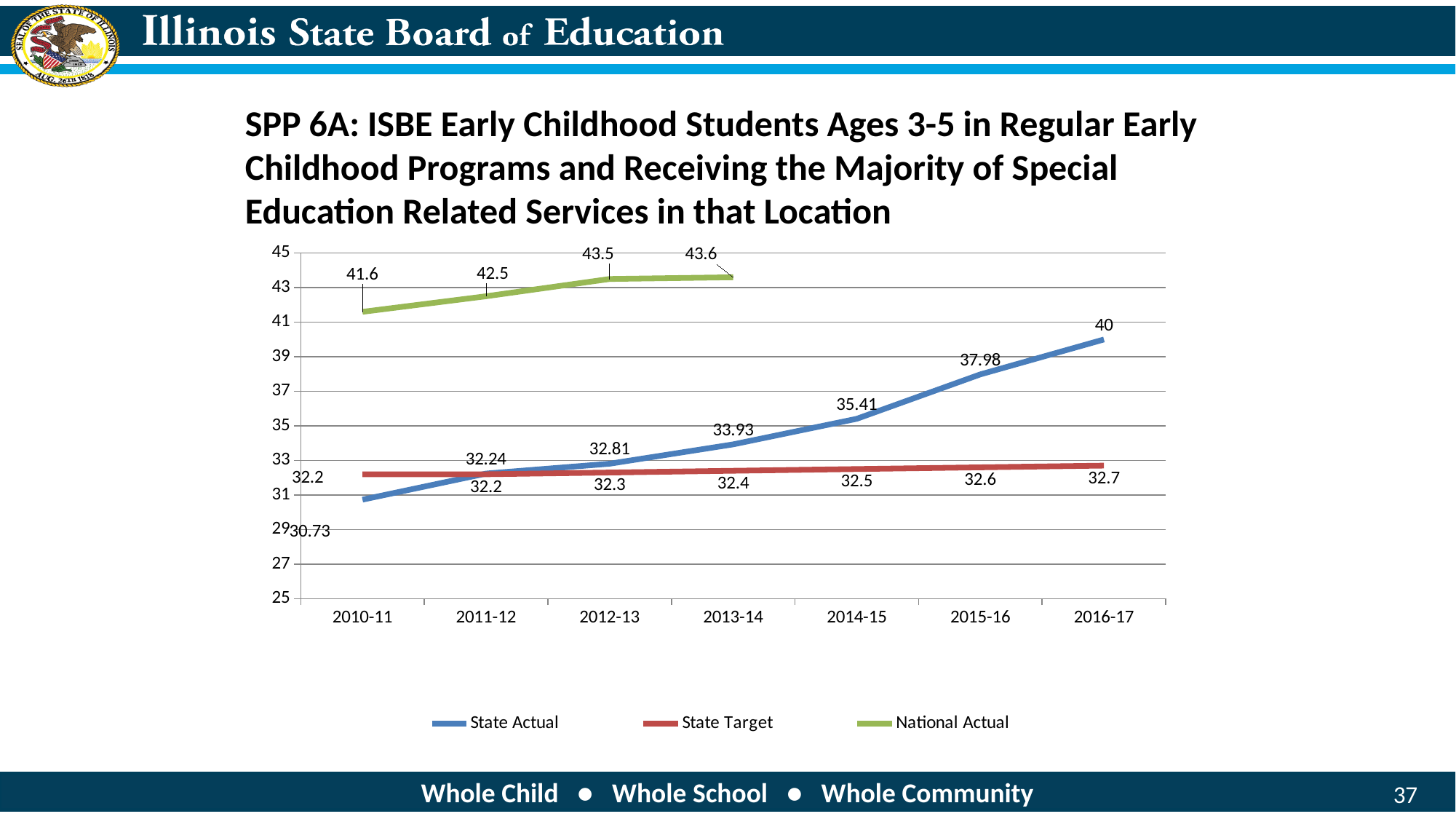
What type of chart is shown on the slide? line chart In which school year is the State Actual value lowest? 2010-11 How many series does the legend list? 3 What is the State Target value for 2013-14? 32.4 In which school year is the National Actual value highest? 2013-14 How many school years are shown on the x axis? 7 What is the National Actual value for 2012-13? 43.5 What is the State Actual value for 2016-17? 40 Does the State Actual series rise or fall from 2010-11 to 2016-17? rise Which is larger in 2011-12, State Actual or State Target? State Actual What is the difference between the State Actual value in 2016-17 and in 2010-11? 9.27 Which series is drawn in green? National Actual